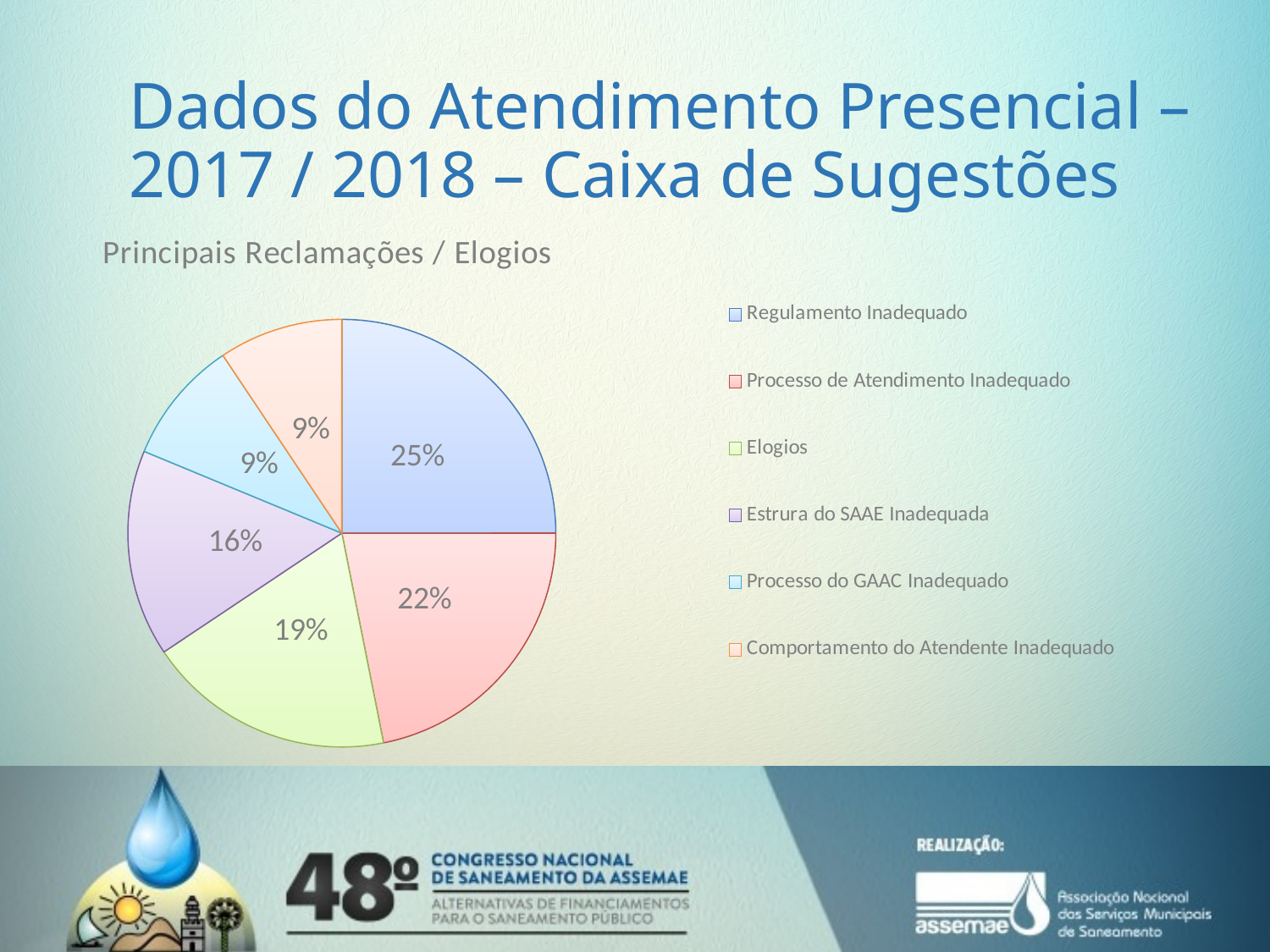
How many categories does the pie chart show? 6 What is the subtitle shown above the chart? Principais Reclamações / Elogios What percentage does Estrura do SAAE Inadequada account for? 16% What percentage is shown for Processo de Atendimento Inadequado? 22% Which category has the largest share of the pie? Regulamento Inadequado What share of the pie is labelled Elogios? 19% What percentage is shown for Processo do GAAC Inadequado? 9% Which is larger, the share for Processo de Atendimento Inadequado or the share for Estrura do SAAE Inadequada? Processo de Atendimento Inadequado What type of chart is shown on the slide? Pie chart What is the smallest percentage value shown on the pie chart? 9% What share of the pie does Regulamento Inadequado represent? 25% What is the difference in percentage points between Regulamento Inadequado and Elogios? 6